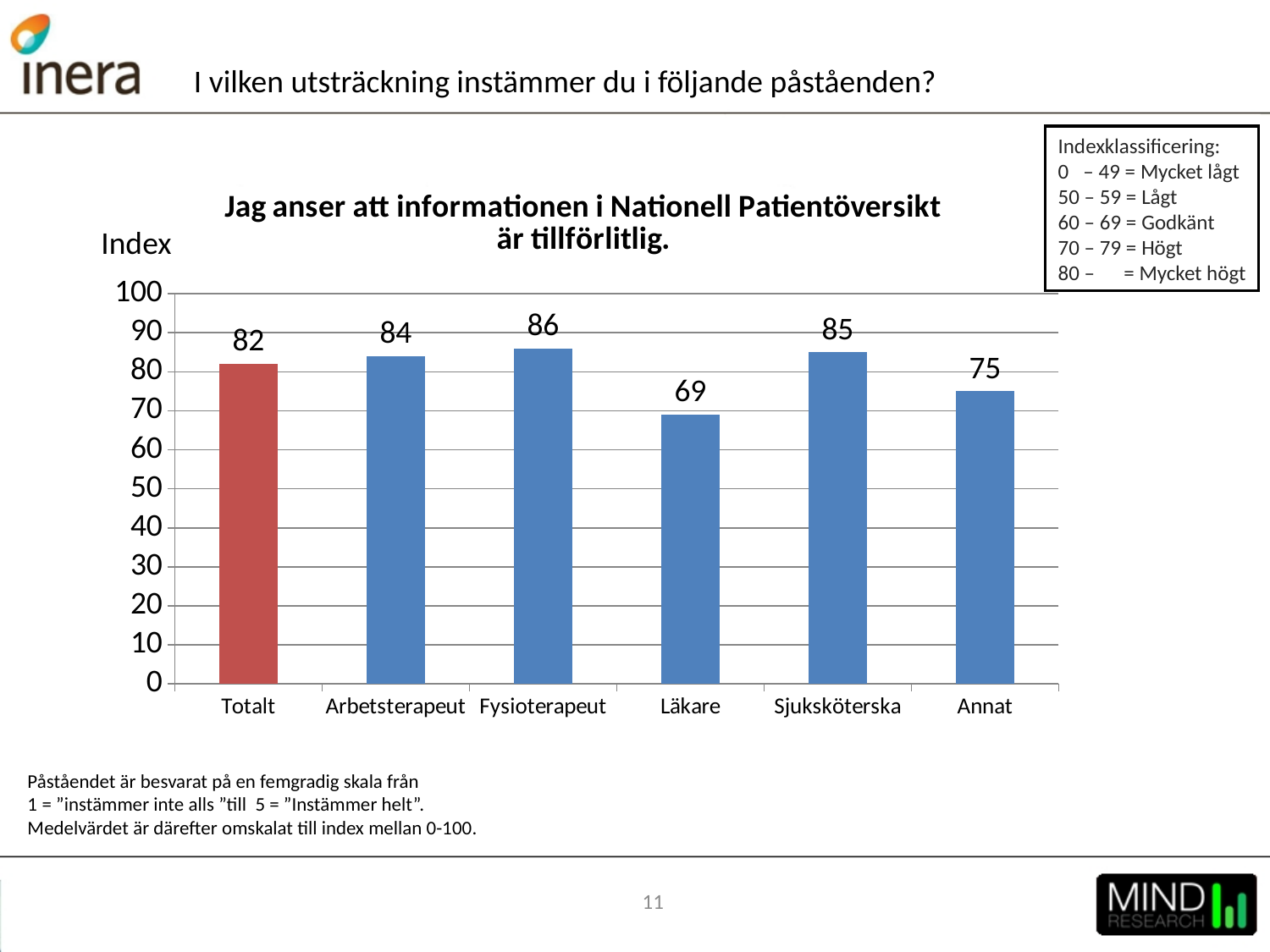
What kind of chart is shown on the slide? Bar chart Which has a higher index value, Arbetsterapeut or Annat? Arbetsterapeut How many categories are shown on the x axis? 6 Which category has the lowest index value? Läkare What is the difference between the index values for Sjuksköterska and Annat? 10 What is the index value for Totalt? 82 Which bar is shown in a different colour (red) from the others? Totalt What is the difference between the index values for Fysioterapeut and Läkare? 17 Which category has the highest index value? Fysioterapeut What is the index value for Annat? 75 Is the value for Läkare greater or less than 70? less What is the index value for Läkare? 69